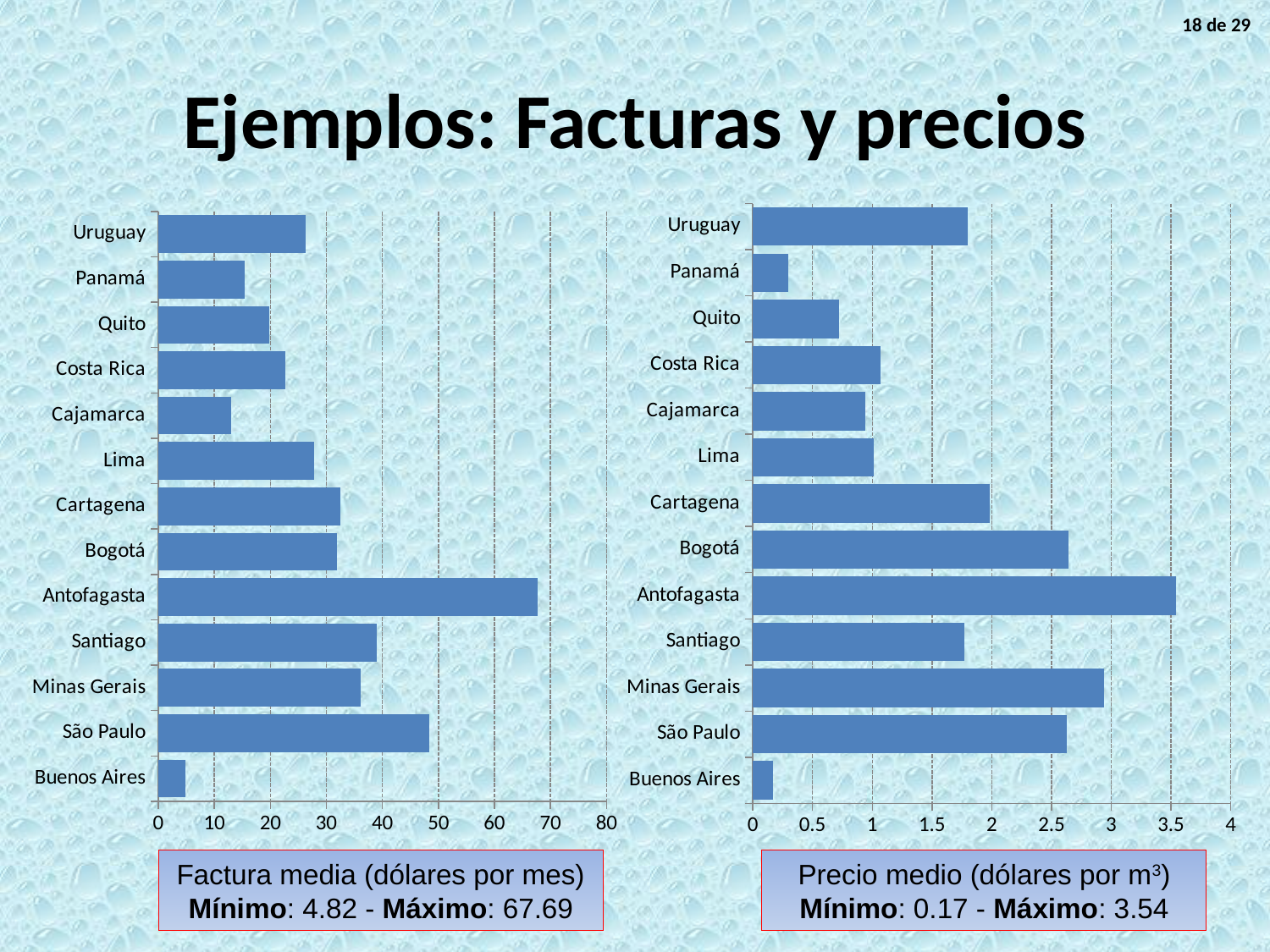
What unit does the caption give for the right chart (Precio medio)? dólares por m³ On the right chart (Precio medio), what is the difference between the maximum (Antofagasta) and the minimum (Buenos Aires)? 3.37 On the right chart (Precio medio), what is the value for Buenos Aires? 0.17 What kind of chart is the right chart (Precio medio)? bar chart On the left chart (Factura media), what is the value for Antofagasta? 67.69 On the left chart (Factura media), is the value for São Paulo greater or less than 40? greater On the right chart (Precio medio), which category has the lowest value? Buenos Aires On the left chart (Factura media), which is larger, Cartagena or Lima? Cartagena On the left chart (Factura media), which category has the highest value? Antofagasta How many categories are shown on the left chart (Factura media)? 13 On the left chart (Factura media), what is the difference between the maximum (Antofagasta) and the minimum (Buenos Aires)? 62.87